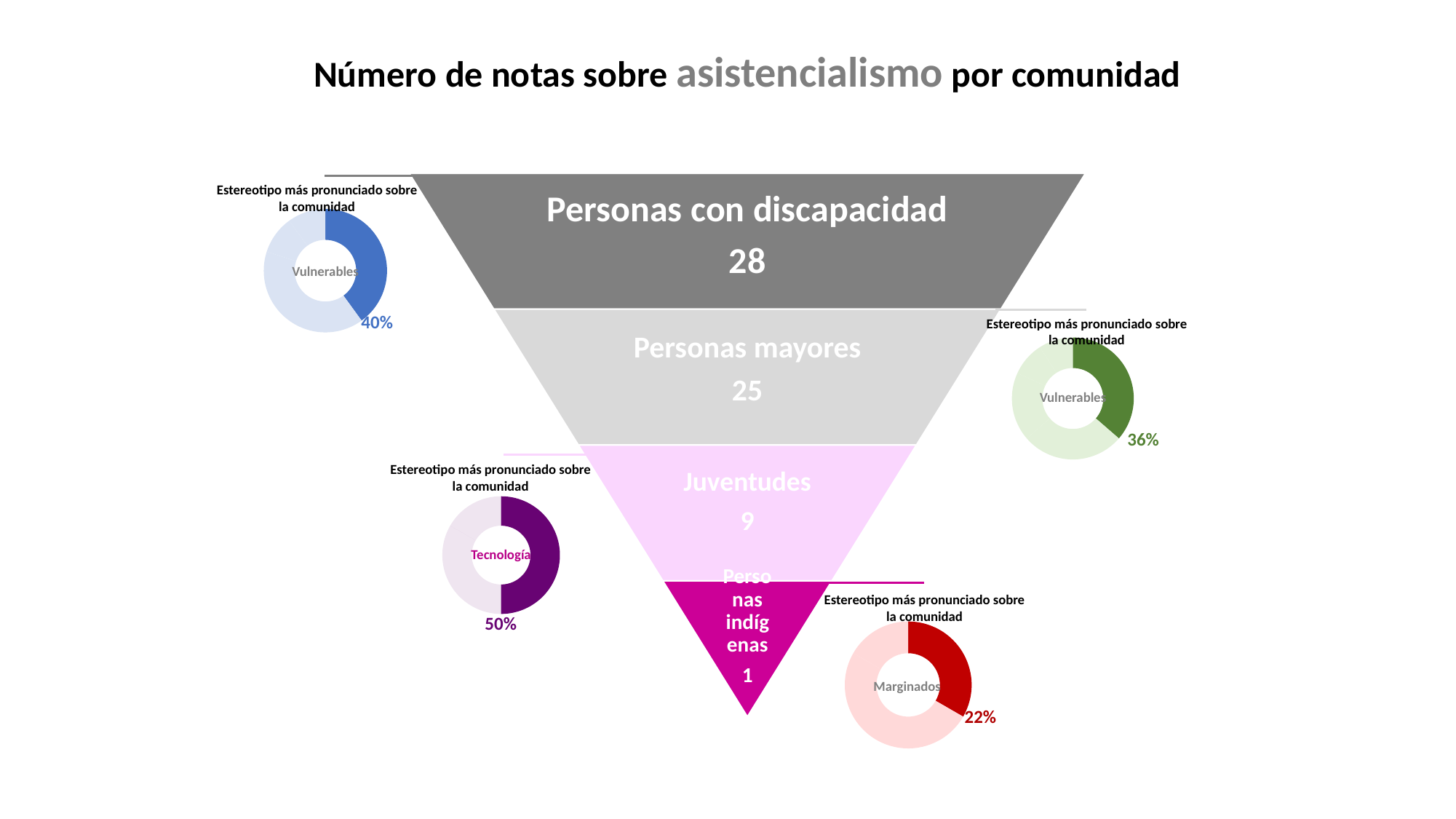
In the top-left donut chart, what percentage is shown for the Vulnerables stereotype? 40% In the central funnel chart, which community has the lowest number of notes? Personas indígenas In the central funnel chart, how many notes are there for Juventudes? 9 What is the title of the slide's main chart? Número de notas sobre asistencialismo por comunidad In the central funnel chart, which has more notes, Juventudes or Personas mayores? Personas mayores In the central funnel chart, how many notes are there for Personas con discapacidad? 28 In the central funnel chart, which community has the highest number of notes? Personas con discapacidad In the bottom-right donut chart, what percentage is shown for the Marginados stereotype? 22% How many communities are shown in the central funnel chart? 4 In the central funnel chart, how many notes are there for Personas mayores? 25 In the central funnel chart, what is the difference between the number of notes for Personas con discapacidad and Personas mayores? 3 In the donut chart on the right side of the slide, what percentage is shown for the Vulnerables stereotype? 36%